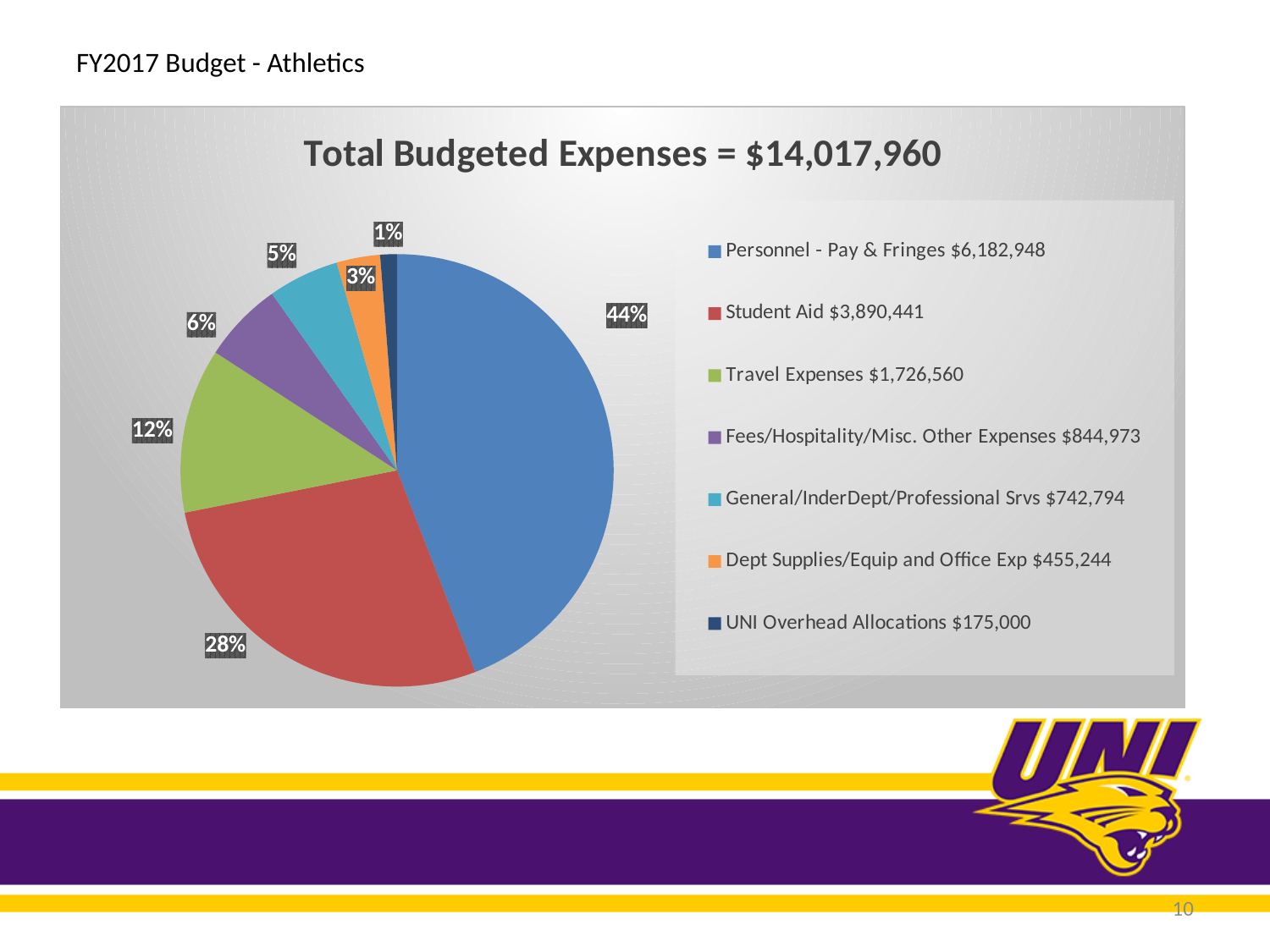
What dollar amount is shown in the legend for Dept Supplies/Equip and Office Exp? $455,244 What share of the pie does UNI Overhead Allocations represent? 1% What is the title of the chart? Total Budgeted Expenses = $14,017,960 How many slices does the pie chart have? 7 What kind of chart is shown on the slide? pie chart Which category has the smallest slice of the pie? UNI Overhead Allocations Which is larger, the share for Fees/Hospitality/Misc. Other Expenses or the share for General/InderDept/Professional Srvs? Fees/Hospitality/Misc. Other Expenses What share of the pie does Student Aid represent? 28% What dollar amount is shown in the legend for Student Aid? $3,890,441 Which category has the largest slice of the pie? Personnel - Pay & Fringes What share of the pie does Personnel - Pay & Fringes represent? 44%